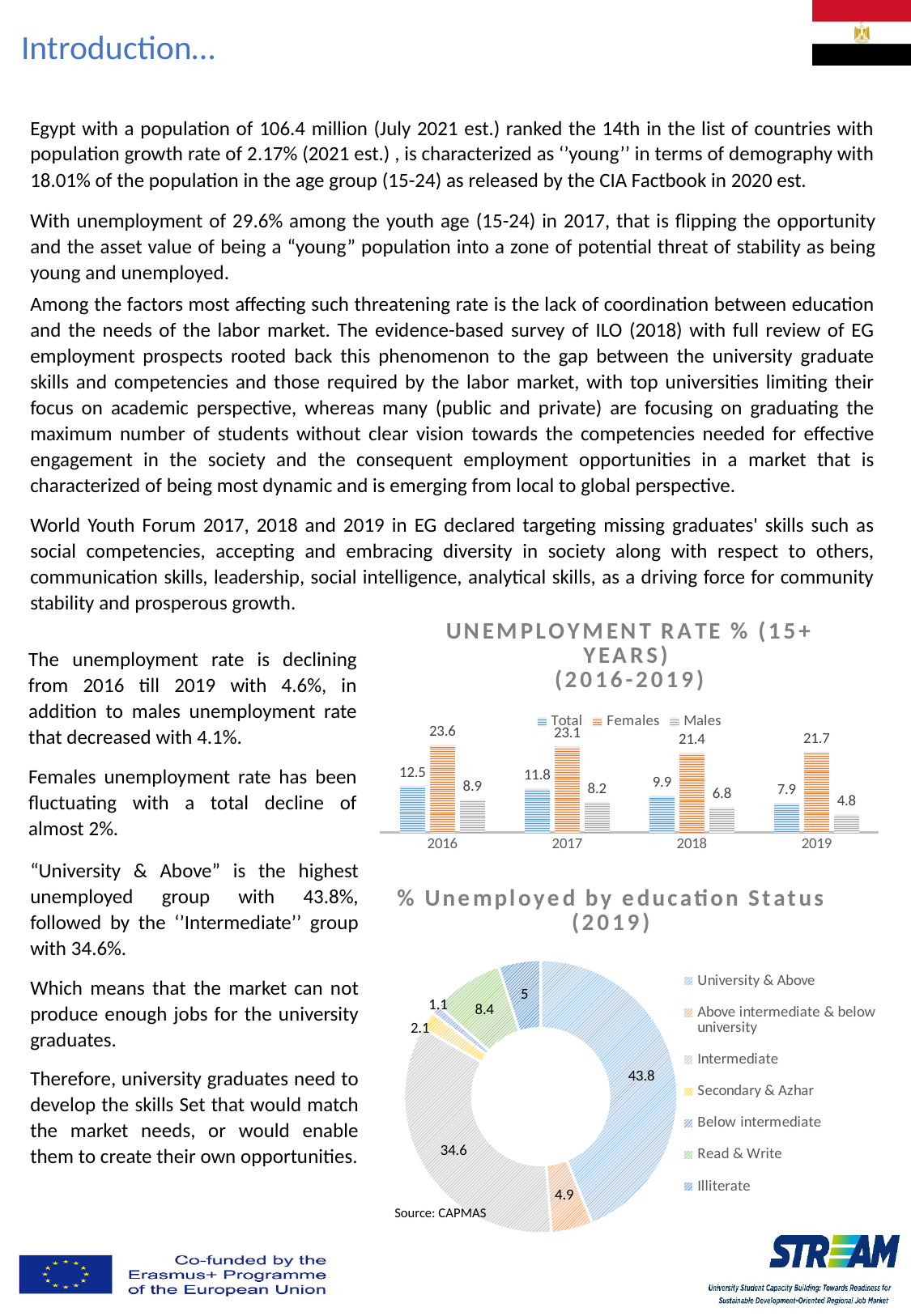
How many categories does the legend of the '% Unemployed by education Status (2019)' chart list? 7 In the 'UNEMPLOYMENT RATE % (15+ YEARS)' chart, what is the Females value for 2016? 23.6 In the 'UNEMPLOYMENT RATE % (15+ YEARS)' chart, which year has the lowest Males value? 2019 In the 'UNEMPLOYMENT RATE % (15+ YEARS)' chart, does the Total series rise or fall from 2016 to 2019? fall In the '% Unemployed by education Status (2019)' chart, what is the value for Intermediate? 34.6 In the 'UNEMPLOYMENT RATE % (15+ YEARS)' chart, what is the Males value for 2018? 6.8 What kind of chart is the 'UNEMPLOYMENT RATE % (15+ YEARS)' chart? bar chart In the '% Unemployed by education Status (2019)' chart, which category has the largest share? University & Above How many series does the legend of the 'UNEMPLOYMENT RATE % (15+ YEARS)' chart list? 3 In the 'UNEMPLOYMENT RATE % (15+ YEARS)' chart, what is the Total value for 2019? 7.9 In the '% Unemployed by education Status (2019)' chart, which is larger: Read & Write or Illiterate? Read & Write In the 'UNEMPLOYMENT RATE % (15+ YEARS)' chart, what is the difference between the Total values for 2016 and 2019? 4.6